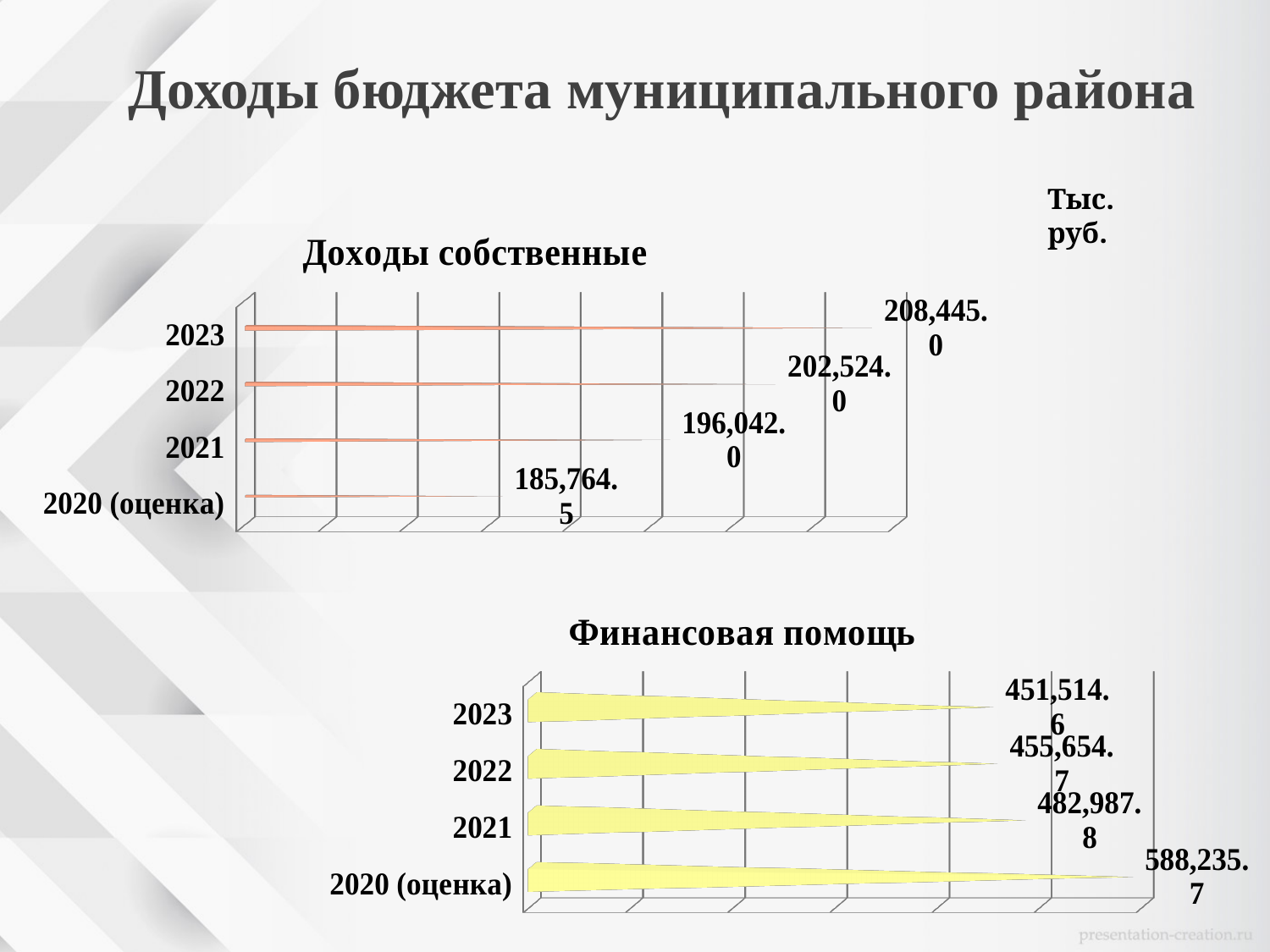
In the chart titled "Доходы собственные", which year has the highest value? 2023 In the chart titled "Доходы собственные", what is the value for 2023? 208,445.0 In the chart titled "Доходы собственные", what is the difference between the values for 2023 and 2020 (оценка)? 22,680.5 In the chart titled "Доходы собственные", which is larger: the value for 2022 or the value for 2021? 2022 In the chart titled "Финансовая помощь", what is the value for 2021? 482,987.8 In the chart titled "Доходы собственные", what is the value for 2020 (оценка)? 185,764.5 In the chart titled "Финансовая помощь", what is the value for 2023? 451,514.6 In the chart titled "Финансовая помощь", what is the difference between the values for 2020 (оценка) and 2023? 136,721.1 In the chart titled "Финансовая помощь", which year has the lowest value? 2023 What kind of chart is the chart titled "Доходы собственные"? Bar chart In the chart titled "Финансовая помощь", which year has the highest value? 2020 (оценка) How many categories are shown in the chart titled "Финансовая помощь"? 4